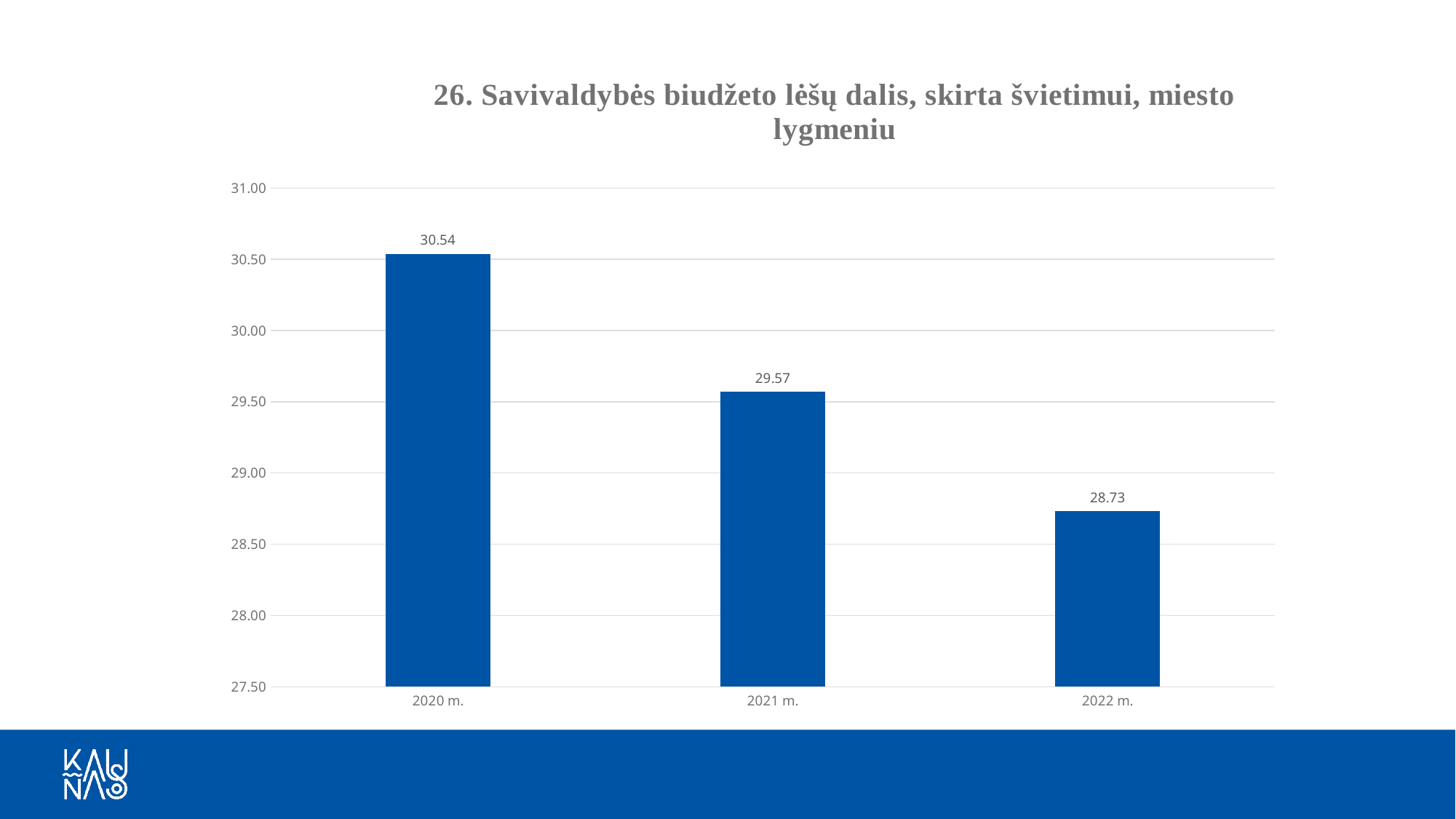
What is the value for 2020 m.? 30.54 How many years are shown on the chart? 3 Is the value for 2021 m. greater or less than 30.00? less What is the difference between the values for 2020 m. and 2022 m.? 1.81 Which year has the lowest value? 2022 m. What is the difference between the values for 2020 m. and 2021 m.? 0.97 Which year has the highest value? 2020 m. Do the values rise or fall from 2020 m. to 2022 m.? fall Which is larger, the value for 2021 m. or the value for 2022 m.? 2021 m. What is the value for 2021 m.? 29.57 What is the value for 2022 m.? 28.73 What kind of chart is shown on the slide? bar chart